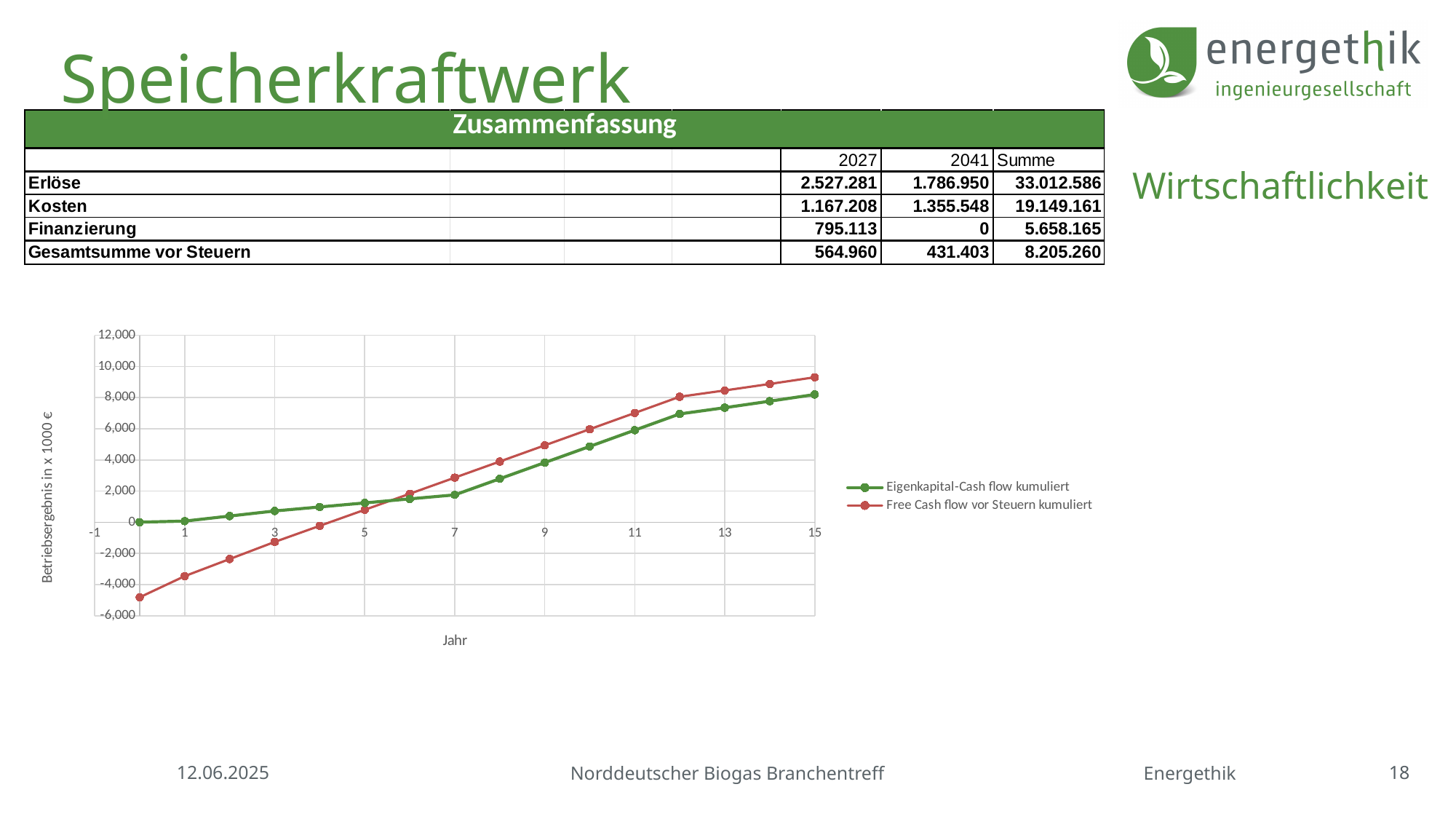
What are the two series named in the chart legend? Eigenkapital-Cash flow kumuliert; Free Cash flow vor Steuern kumuliert What kind of chart is shown on the slide? line chart Does the Eigenkapital-Cash flow kumuliert series rise or fall along the x axis? rise How many series does the chart legend list? 2 At year 15, which series has the higher value: Eigenkapital-Cash flow kumuliert or Free Cash flow vor Steuern kumuliert? Free Cash flow vor Steuern kumuliert Is the value of Free Cash flow vor Steuern kumuliert at year 3 greater or less than 0? less At year 1, which series has the higher value: Eigenkapital-Cash flow kumuliert or Free Cash flow vor Steuern kumuliert? Eigenkapital-Cash flow kumuliert Is the value of Eigenkapital-Cash flow kumuliert at year 7 greater or less than 2,000? less What is the label of the vertical axis of the chart? Betriebsergebnis in x 1000 € Is the value of Free Cash flow vor Steuern kumuliert at year 15 greater or less than 8,000? greater Does the Free Cash flow vor Steuern kumuliert series rise or fall as the year increases? rise